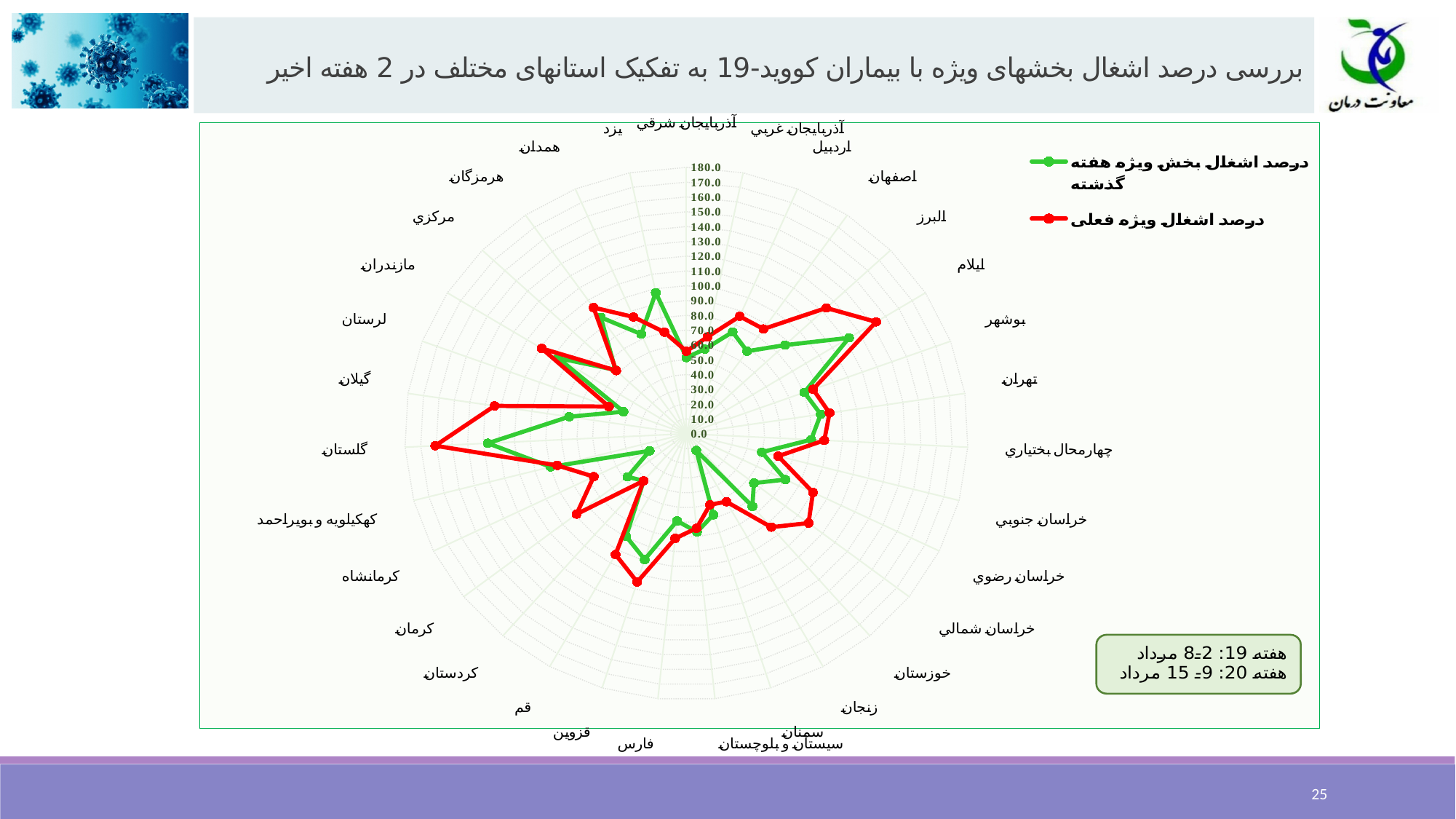
Which province has the highest value for the red series (درصد اشغال ویژه فعلی)? گلستان Which colour represents the series درصد اشغال ویژه فعلی in the legend? red Is the value for گلستان in the red series (درصد اشغال ویژه فعلی) greater or less than 150? greater How many series does the chart legend list? 2 For بوشهر, which series has the larger value: the red series or the green series? the red series (درصد اشغال ویژه فعلی) What is the maximum value shown on the radar chart's axis scale? 180.0 Is the value for گلستان in the green series (درصد اشغال بخش ویژه هفته گذشته) greater or less than 100? greater Is the value for بوشهر in the red series (درصد اشغال ویژه فعلی) greater or less than 100? less How many provinces (categories) are plotted around the radar chart? 31 For گلستان, which series has the larger value: درصد اشغال ویژه فعلی (red) or درصد اشغال بخش ویژه هفته گذشته (green)? درصد اشغال ویژه فعلی (red) What kind of chart is shown on the slide? radar chart Which province has the highest value for the green series (درصد اشغال بخش ویژه هفته گذشته)? گلستان